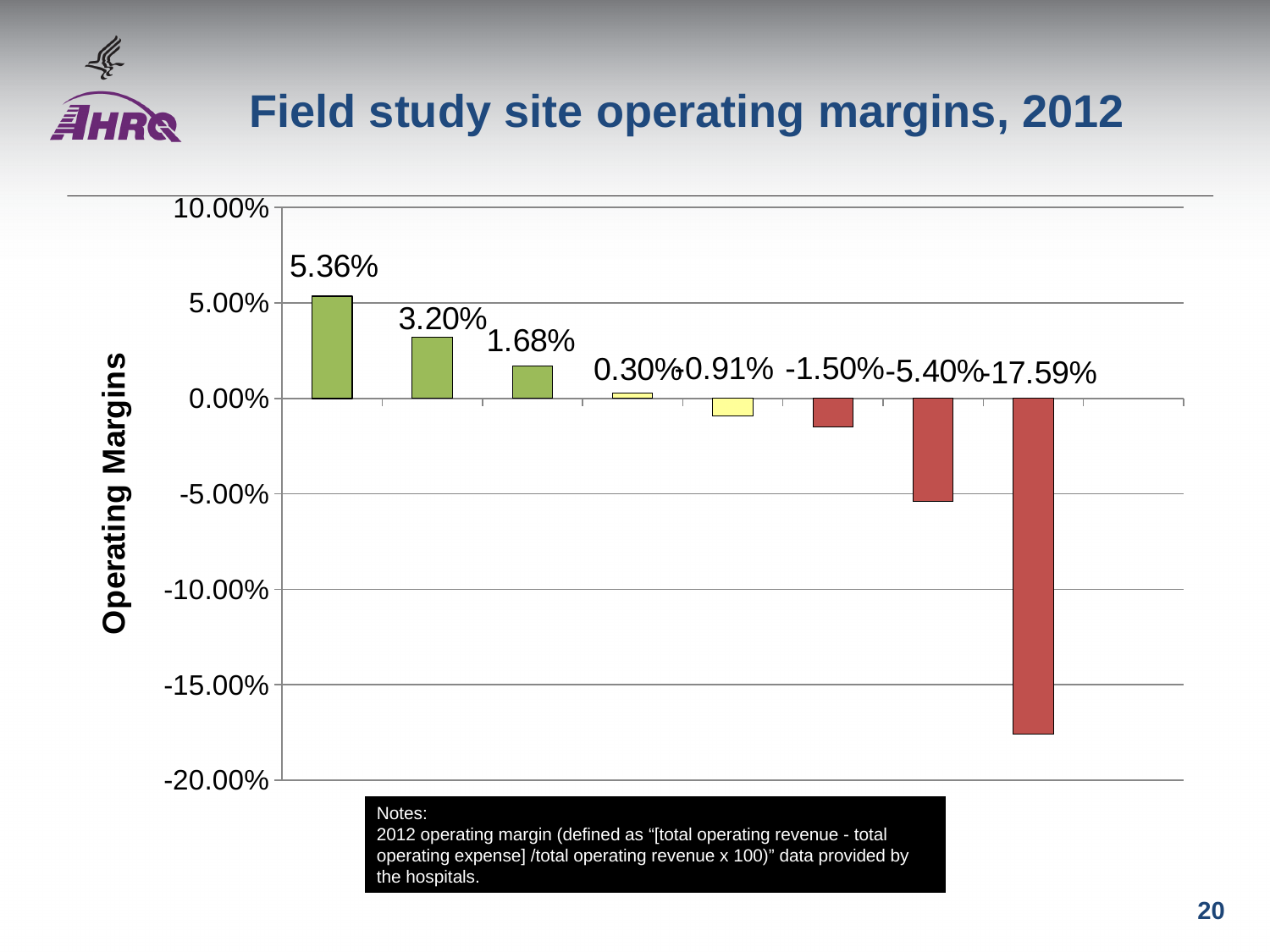
What is the value of the leftmost (first) bar? 5.36% What is the difference between the first bar (5.36%) and the second bar (3.20%)? 2.16% What kind of chart is shown on the slide? bar chart Is the value of the seventh bar from the left greater or less than -5.00%? less How many bars are plotted in the chart? 8 What is the title of the vertical axis? Operating Margins What is the highest operating margin shown in the chart? 5.36% Do the values rise or fall moving from left to right across the bars? fall What is the lowest operating margin shown in the chart? -17.59% What is the value of the rightmost (last) bar? -17.59% What is the value of the third bar from the left? 1.68% Which is larger, the value of the fourth bar (0.30%) or the fifth bar (-0.91%)? 0.30%